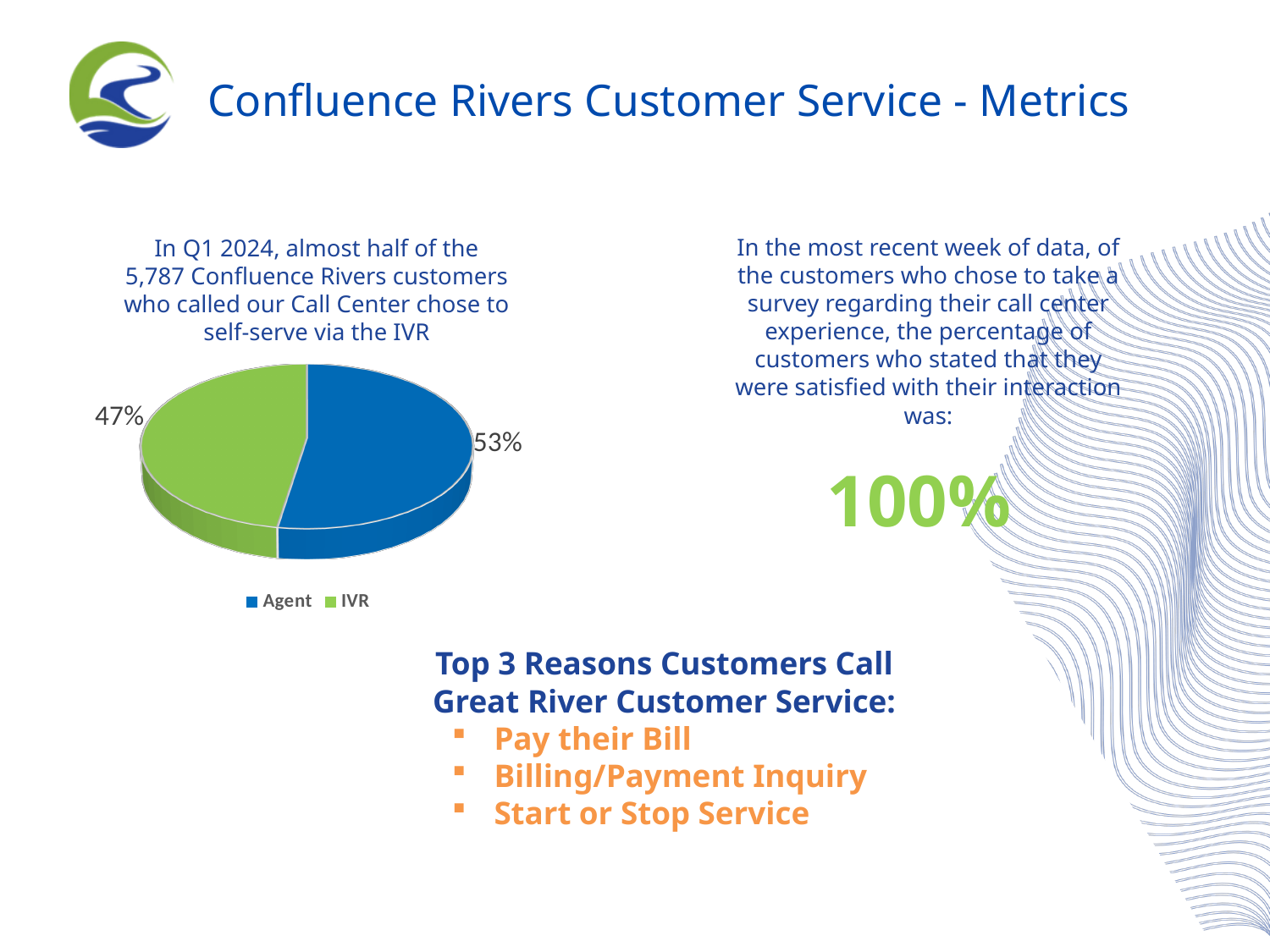
What colour is the Agent slice in the pie chart? blue Which slice of the pie chart is larger, Agent or IVR? Agent How many slices does the pie chart have? 2 What kind of chart is shown on the slide? pie chart Is the share for IVR greater or less than 50%? less Which category has the smallest share of the pie chart? IVR Which category has the largest share of the pie chart? Agent How many entries does the pie chart legend list? 2 What colour is the IVR slice in the pie chart? green What percentage of the pie chart is labelled IVR? 47% What is the difference in percentage points between the Agent and IVR slices? 6 What percentage of the pie chart is labelled Agent? 53%